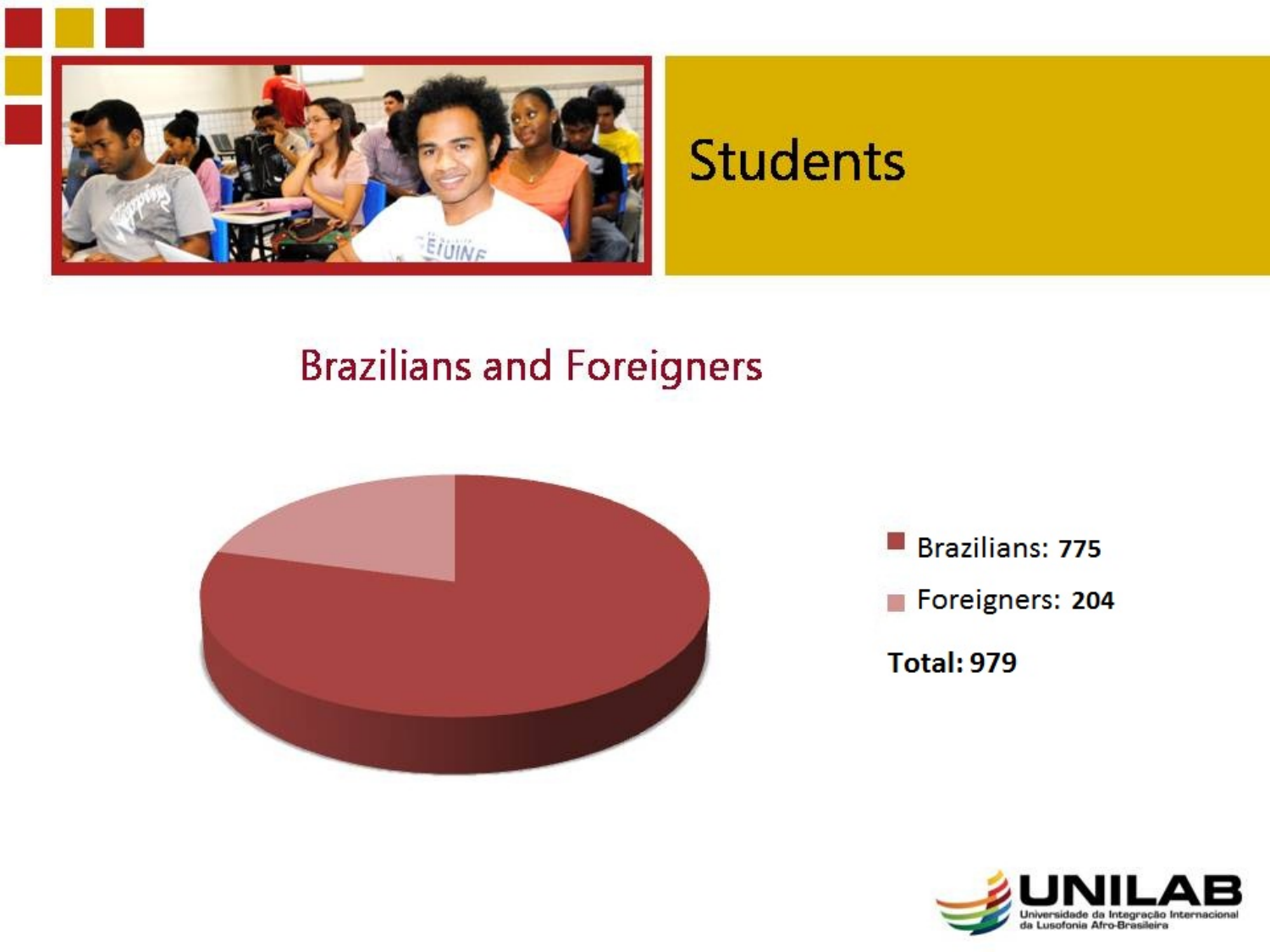
What type of chart is shown on the slide? Pie chart Which category has the smaller slice of the pie? Foreigners How many categories does the pie chart have? 2 How many foreign students are shown in the chart? 204 What is the title of the chart? Brazilians and Foreigners Which category is shown in the lighter pink colour? Foreigners How many Brazilian students are shown in the chart? 775 Are there more Brazilians or Foreigners among the students? Brazilians What is the total number of students shown on the slide? 979 Which category has the larger slice of the pie? Brazilians How many more Brazilians than Foreigners are there? 571